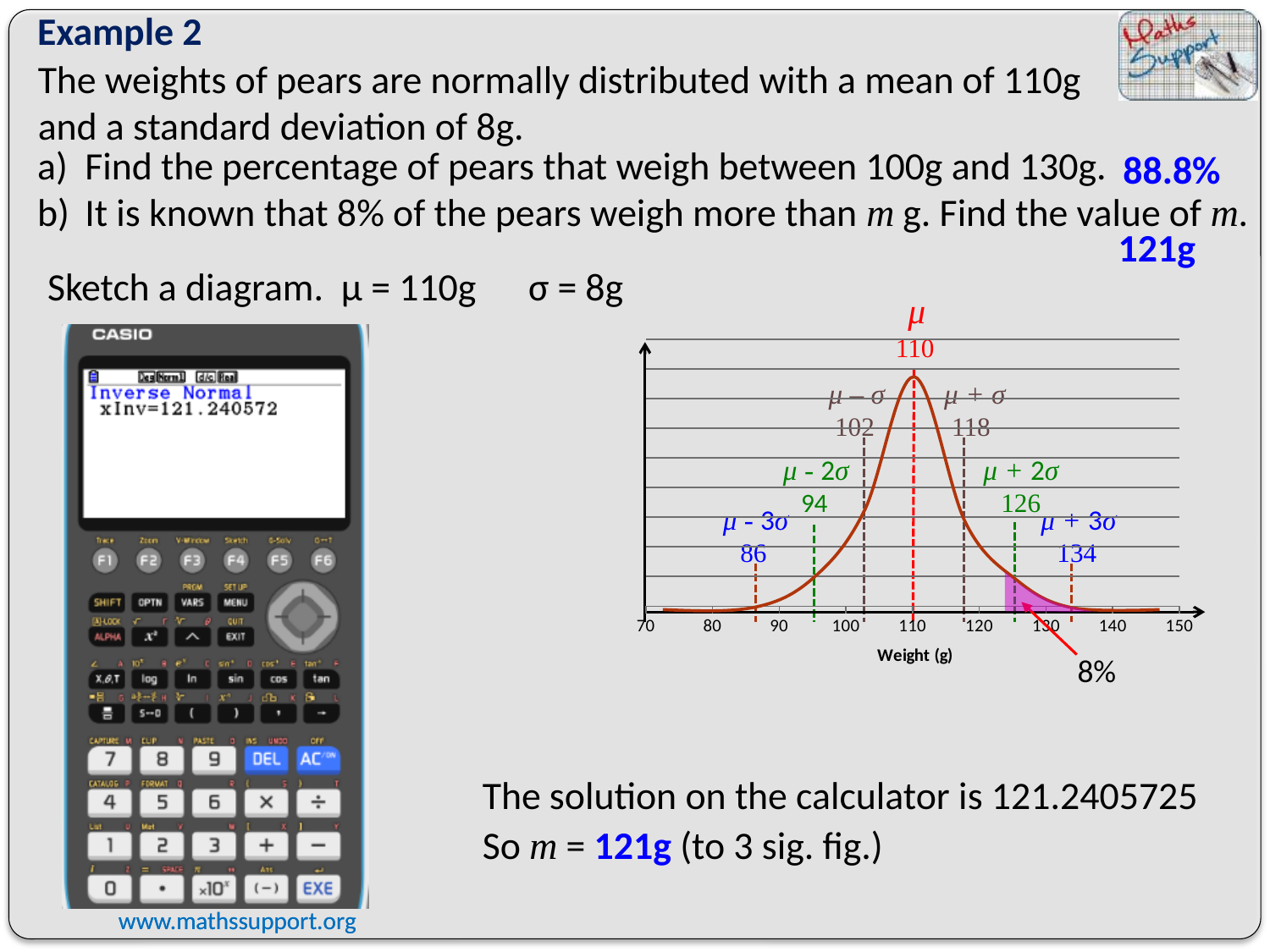
On the normal distribution chart, what value is labelled at μ + σ? 118 At which weight does the curve on the normal distribution chart reach its peak? 110 On the normal distribution chart, what value is labelled at μ − 3σ? 86 On the normal distribution chart, what is the difference between the values labelled at μ + σ and μ − σ? 16 What is the x-axis title of the normal distribution chart? Weight (g) On the normal distribution chart, what value is labelled at μ + 3σ? 134 What kind of chart is the normal distribution diagram? line chart What percentage is written next to the shaded region under the right tail of the curve? 8% Does the curve rise or fall as weight increases from 110 to 150 on the normal distribution chart? fall On the normal distribution chart, what value is labelled at μ − σ? 102 On the normal distribution chart, what value is labelled at μ − 2σ? 94 On the normal distribution chart, what value is labelled at μ? 110